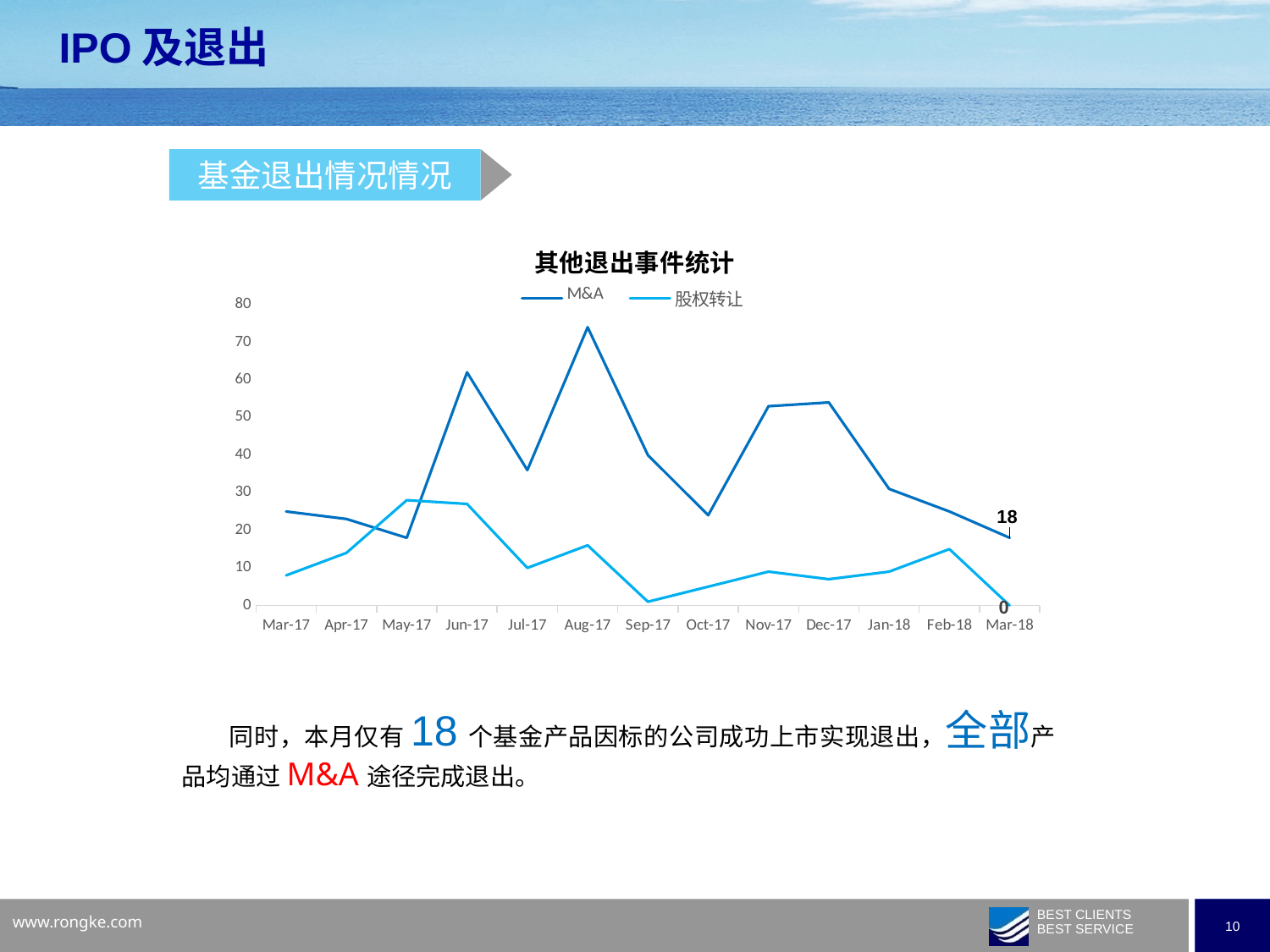
Does the M&A series rise or fall from Dec-17 to Mar-18? fall What kind of chart is shown on the slide? line chart Which series has the larger value in May-17, M&A or 股权转让? 股权转让 What is the value of the M&A series for Mar-18? 18 How many months are plotted along the x axis of the chart? 13 What is the title of the chart? 其他退出事件统计 How many series does the legend of the chart list? 2 What is the value of the 股权转让 series for Mar-18? 0 Is the M&A value for Aug-17 greater or less than 70? greater In which month does the M&A series reach its highest value? Aug-17 Is the M&A value for Oct-17 greater or less than 30? less What is the difference between the M&A value and the 股权转让 value in Mar-18? 18